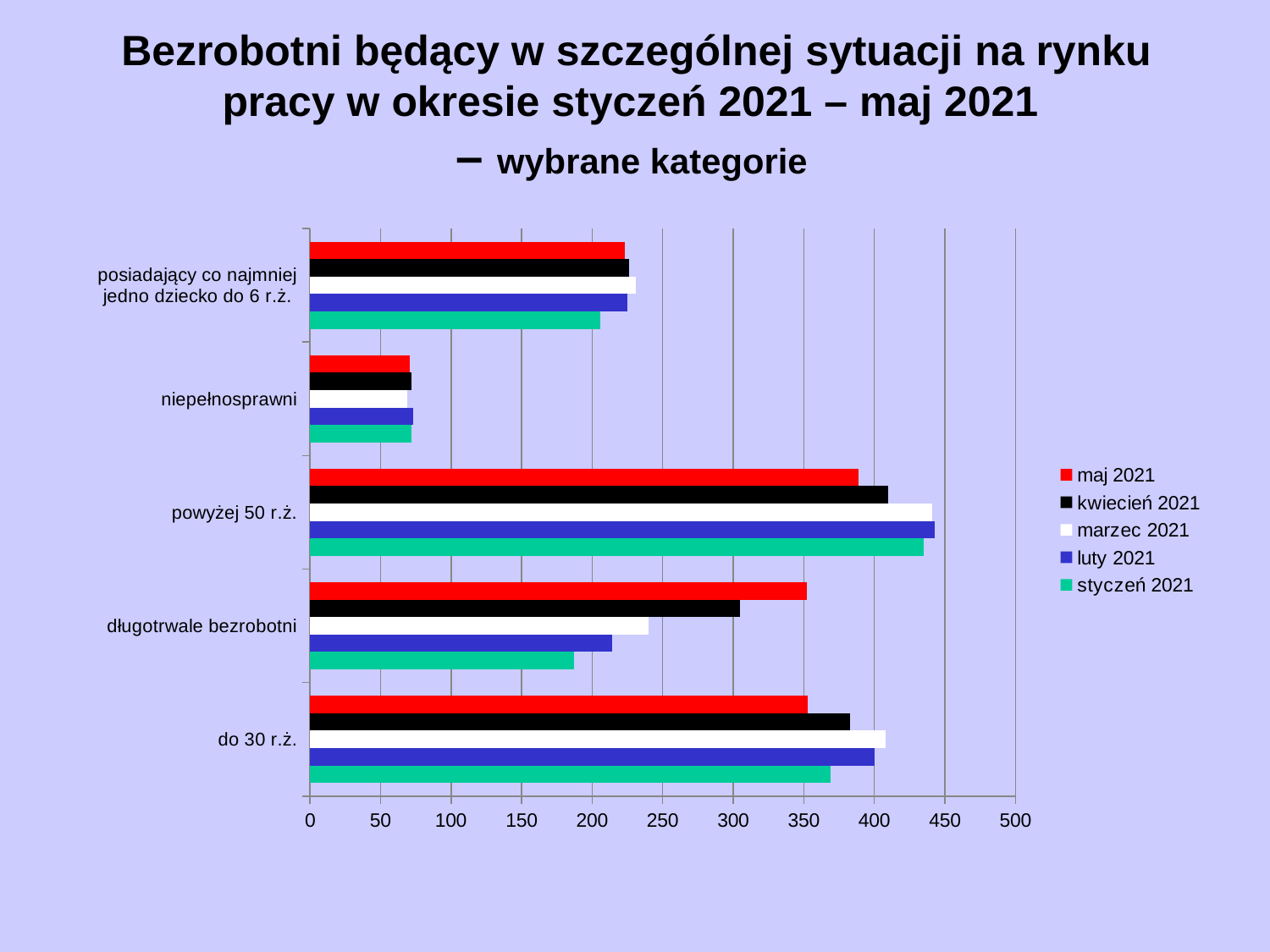
Which colour represents maj 2021 in the legend? red For długotrwale bezrobotni, which is larger: the value for maj 2021 or for styczeń 2021? maj 2021 Which category has the lowest value for maj 2021? niepełnosprawni Which category has the highest value for maj 2021? powyżej 50 r.ż. Is the value for niepełnosprawni in maj 2021 greater or less than 100? less How many series does the legend list? 5 Is the value for do 30 r.ż. in styczeń 2021 greater or less than 350? greater How many categories are shown on the vertical axis of the chart? 5 For powyżej 50 r.ż., which is larger: the value for kwiecień 2021 or for maj 2021? kwiecień 2021 Is the value for długotrwale bezrobotni in maj 2021 greater or less than 300? greater What kind of chart is shown on the slide? bar chart